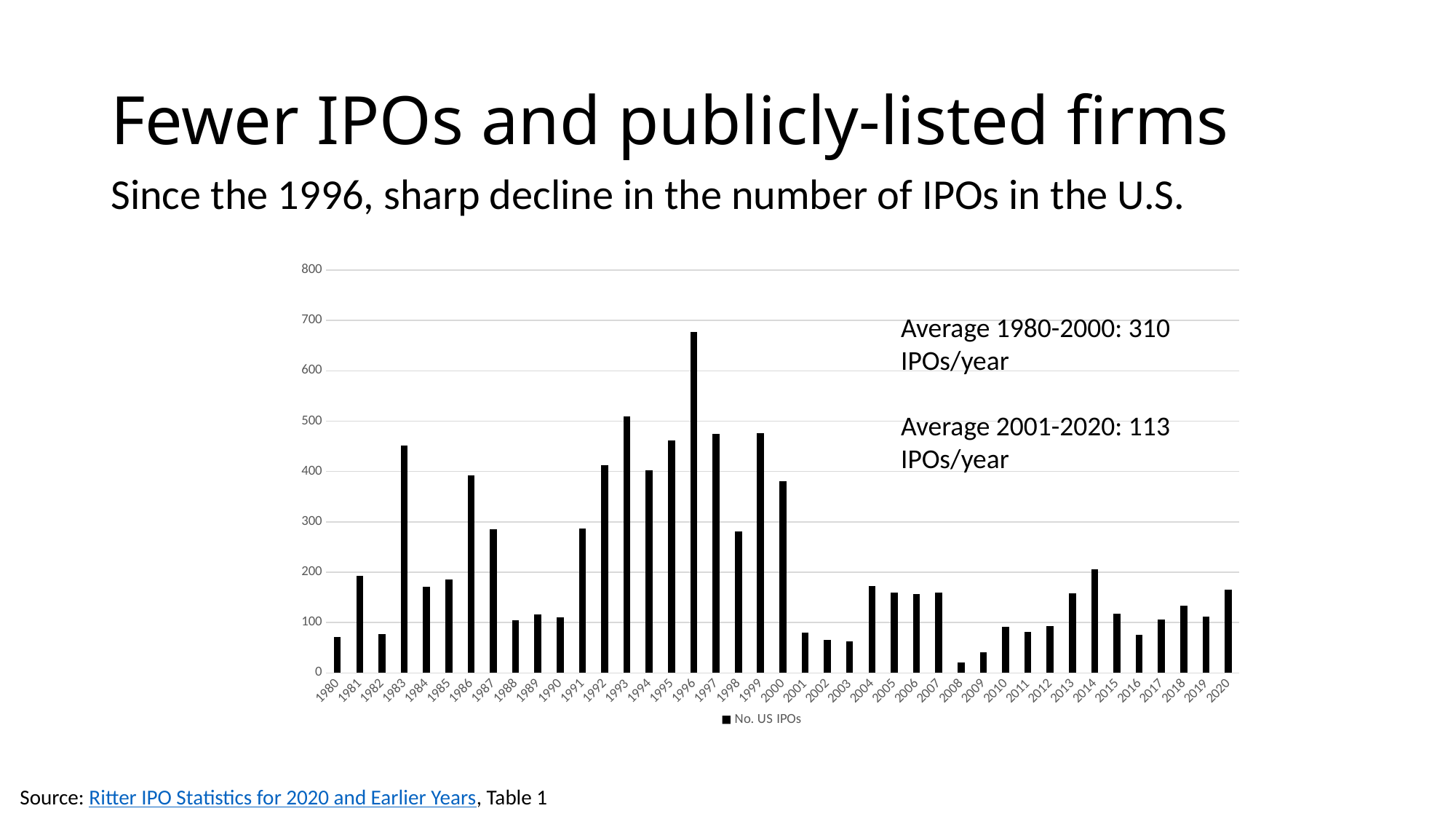
Which year has the highest number of US IPOs? 1996 Is the value for 2001 greater or less than 100? less Is the value for 1996 greater or less than 600? greater What kind of chart is shown on the slide? bar chart Which year has more US IPOs, 1983 or 2014? 1983 Between 1996 and 2003, do the values generally rise or fall? fall How many years are plotted on the x axis? 41 Is the value for 1983 greater or less than 400? greater What is the legend entry for the plotted series? No. US IPOs Which year has the lowest number of US IPOs? 2008 How many series does the legend list? 1